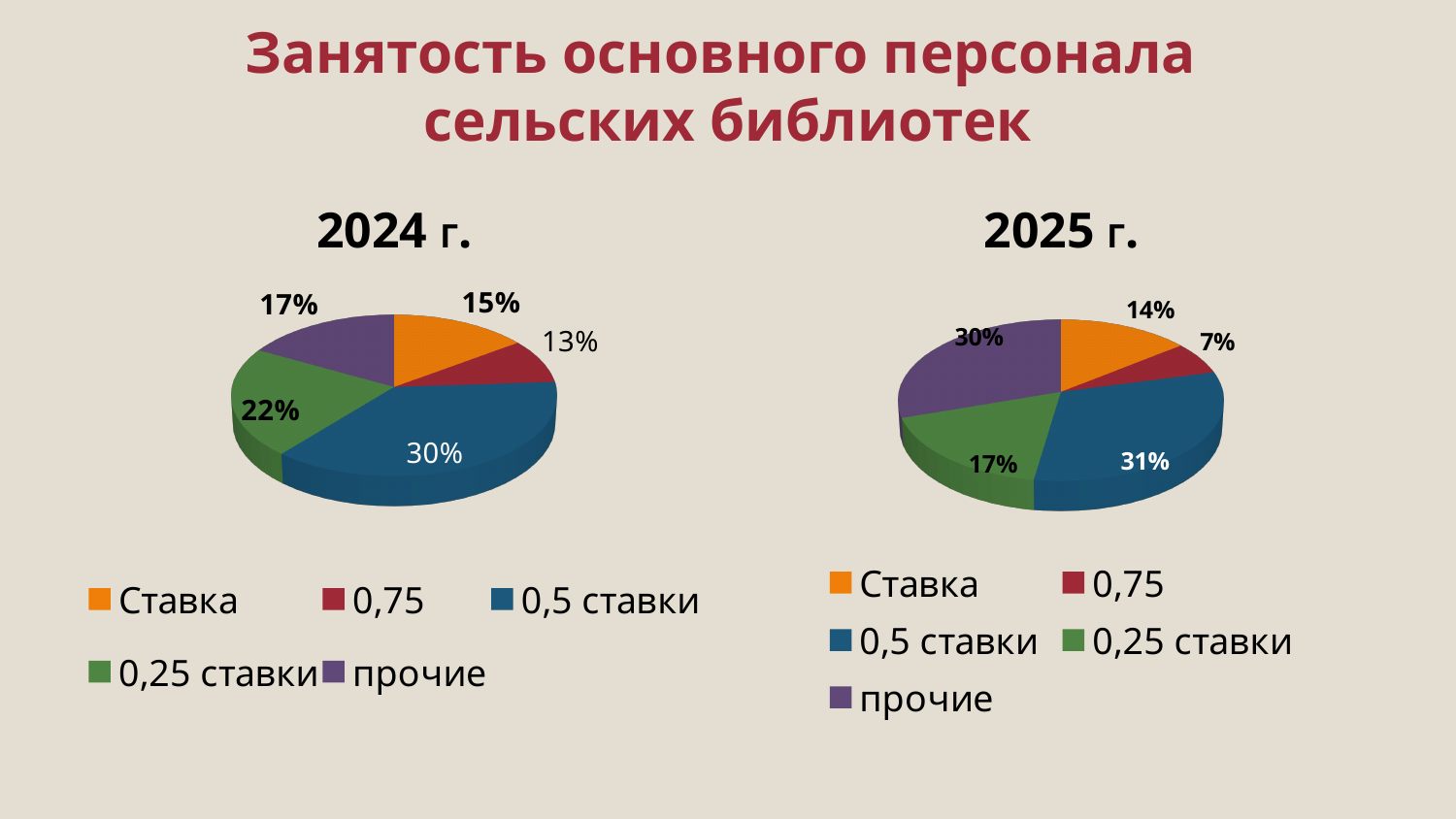
What is the title of the slide? Занятость основного персонала сельских библиотек In the 2024 г. pie chart, which category has the largest share? 0,5 ставки In the 2025 г. pie chart, which category has the smallest share? 0,75 In the 2025 г. pie chart, what share is labelled for the 0,75 slice? 7% In the 2024 г. pie chart, which category has the smallest share? 0,75 In the 2024 г. pie chart, what share is labelled for the 0,5 ставки slice? 30% How many slices does the 2025 г. pie chart have? 5 In the 2025 г. pie chart, what is the difference between the shares of 0,5 ставки and 0,25 ставки? 14% In the 2025 г. pie chart, what share is labelled for the прочие slice? 30% In the 2024 г. pie chart, what share is labelled for the 0,25 ставки slice? 22% In the 2024 г. pie chart, which is larger: the share of Ставка or the share of прочие? прочие What type of chart is used for 2024 г.? pie chart